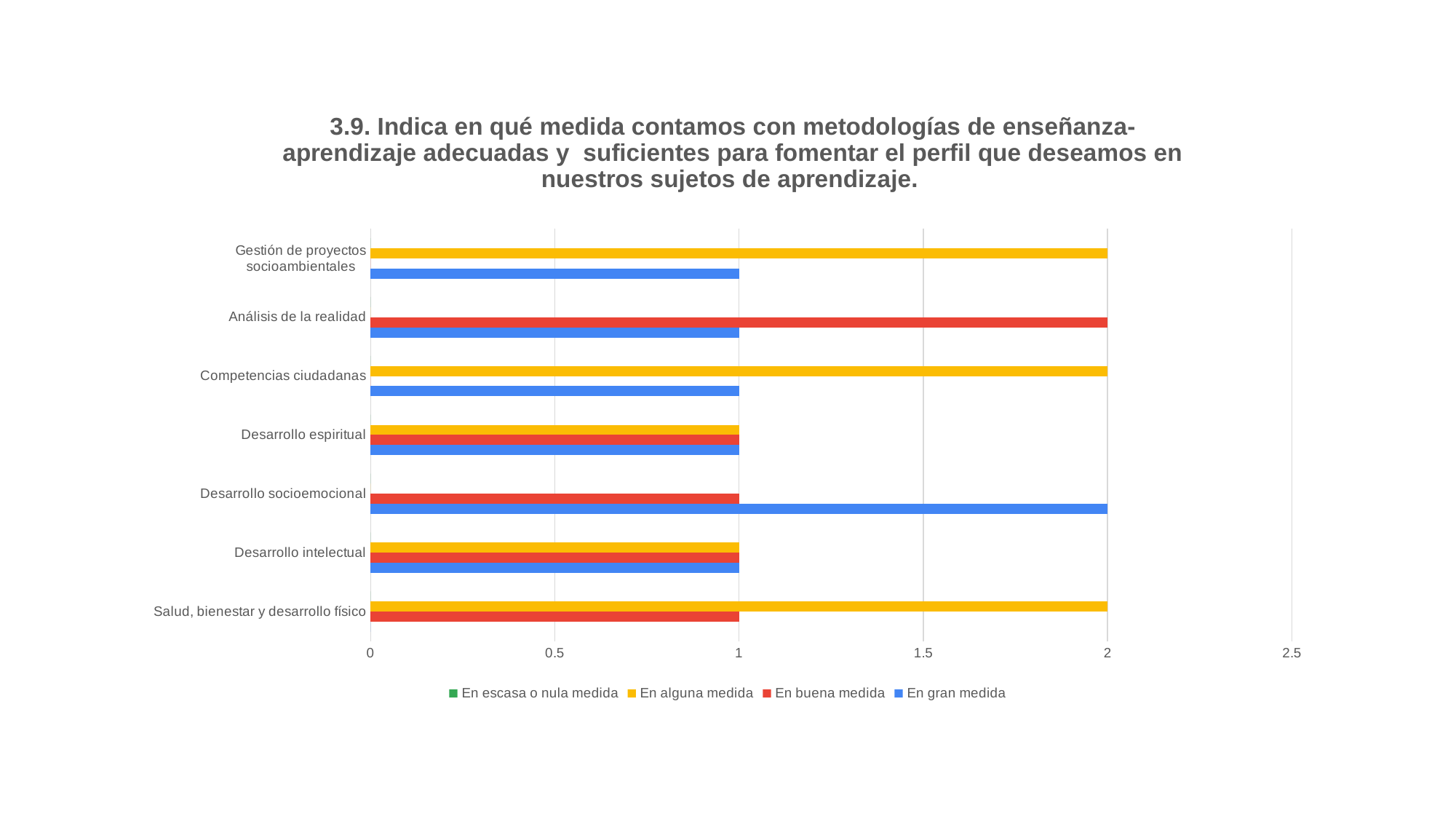
What is the value of 'En gran medida' for 'Desarrollo socioemocional'? 2 What kind of chart is shown on the slide? bar chart What is the value of 'En alguna medida' for 'Salud, bienestar y desarrollo físico'? 2 What is the value of 'En alguna medida' for 'Gestión de proyectos socioambientales'? 2 Which category has the highest value for 'En gran medida'? Desarrollo socioemocional How many categories are listed on the vertical axis of the chart? 7 Which colour represents 'En buena medida' in the legend? red What is the value of 'En gran medida' for 'Competencias ciudadanas'? 1 For 'Desarrollo socioemocional', which is larger: 'En buena medida' or 'En gran medida'? En gran medida What is the value of 'En buena medida' for 'Análisis de la realidad'? 2 How many series does the legend list? 4 What is the difference between 'En alguna medida' and 'En gran medida' for 'Competencias ciudadanas'? 1